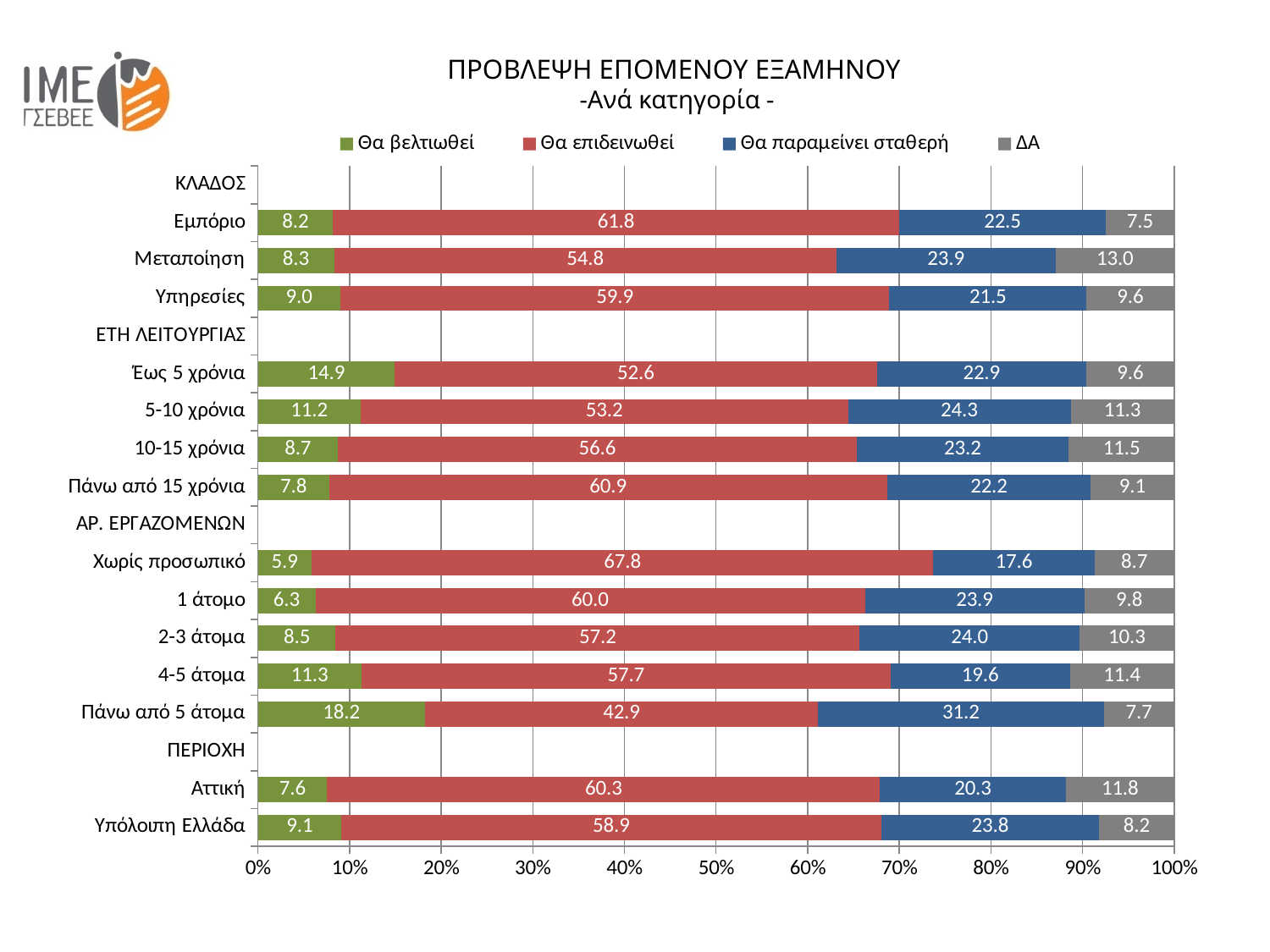
Which has the larger ΔΑ value, Αττική or Υπόλοιπη Ελλάδα? Αττική Which category has the lowest value for Θα επιδεινωθεί? Πάνω από 5 άτομα Which category has the highest value for Θα βελτιωθεί? Πάνω από 5 άτομα What is the value of Θα επιδεινωθεί for Εμπόριο? 61.8 Which category has the highest value for Θα επιδεινωθεί? Χωρίς προσωπικό What is the title of the chart? ΠΡΟΒΛΕΨΗ ΕΠΟΜΕΝΟΥ ΕΞΑΜΗΝΟΥ -Ανά κατηγορία - What is the ΔΑ value for Μεταποίηση? 13.0 What type of chart is shown on the slide? Stacked bar chart What is the value of Θα παραμείνει σταθερή for Πάνω από 5 άτομα? 31.2 What is the difference between the Θα επιδεινωθεί values for Εμπόριο and Μεταποίηση? 7.0 Which category has the lowest value for Θα βελτιωθεί? Χωρίς προσωπικό How many series does the legend list? 4